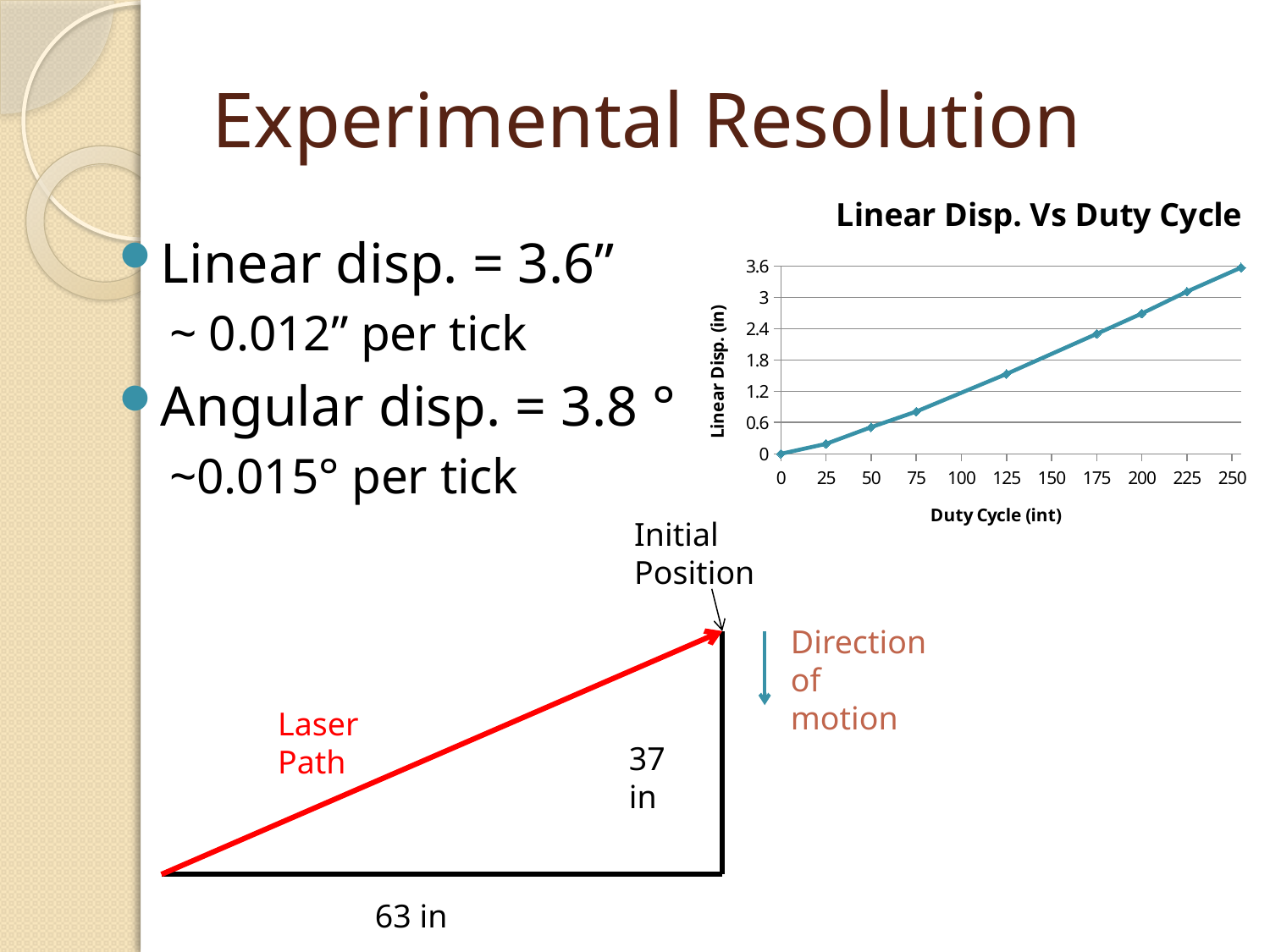
At which duty cycle is the linear displacement lowest? 0 Is the linear displacement at a duty cycle of 25 greater or less than 0.6? less What is the label of the x axis of the chart? Duty Cycle (int) Does the linear displacement rise or fall as the duty cycle increases? rises What kind of chart is shown on the slide? line chart What is the title of the chart? Linear Disp. Vs Duty Cycle Is the linear displacement at a duty cycle of 200 greater or less than 2.4? greater Is the linear displacement at a duty cycle of 125 greater or less than 1.2? greater Which has the larger linear displacement, a duty cycle of 125 or a duty cycle of 200? 200 What is the linear displacement at a duty cycle of 0? 0